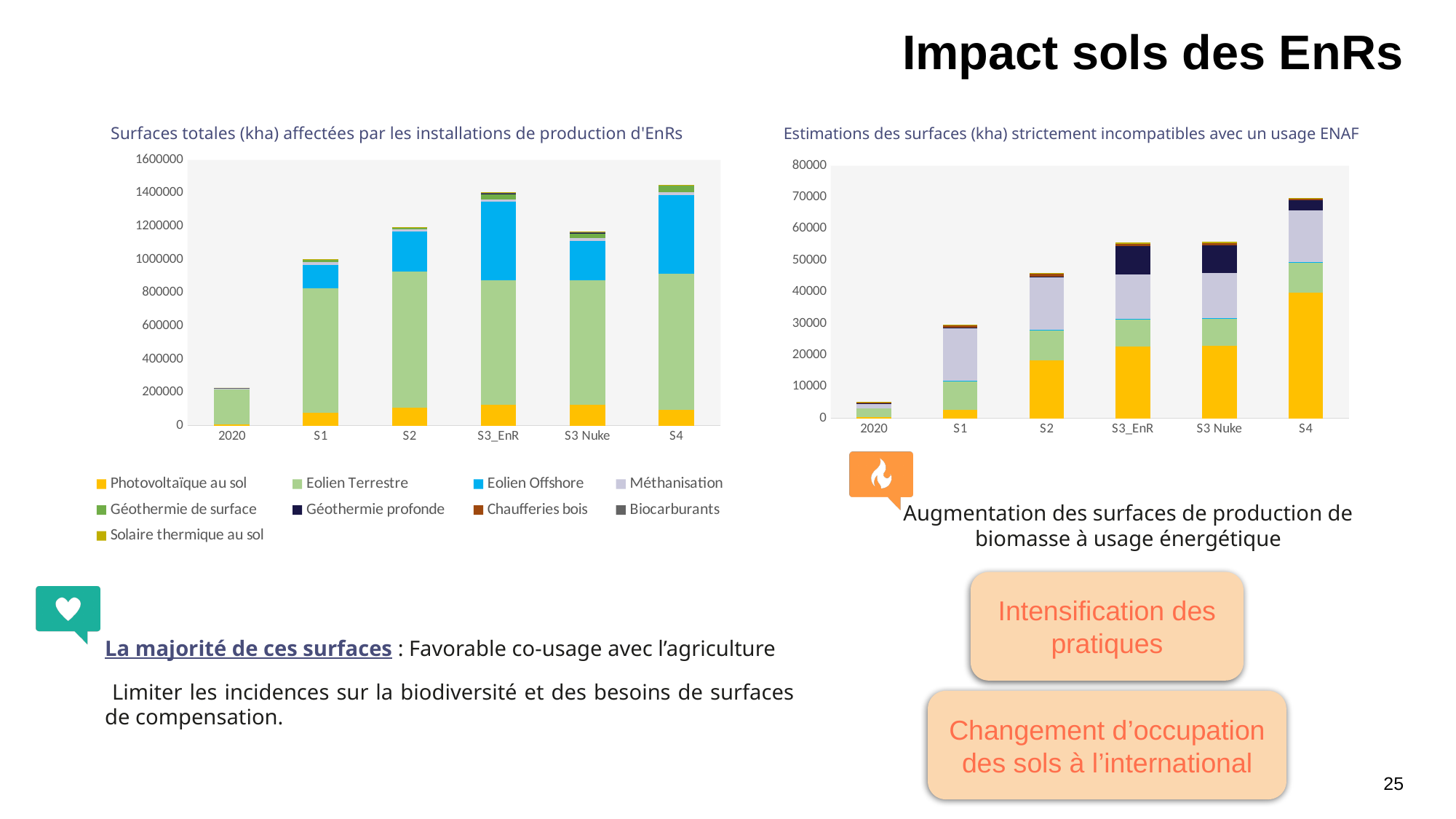
In the left chart, 'Surfaces totales (kha) affectées par les installations de production d'EnRs', which has the larger total, S3_EnR or S3 Nuke? S3_EnR In the left chart, 'Surfaces totales (kha) affectées par les installations de production d'EnRs', is the total for 2020 greater or less than 400000? less In the right chart, 'Estimations des surfaces (kha) strictement incompatibles avec un usage ENAF', do the totals generally rise or fall from 2020 to S4? Rise In the right chart, 'Estimations des surfaces (kha) strictement incompatibles avec un usage ENAF', which category has the highest total? S4 In the left chart, 'Surfaces totales (kha) affectées par les installations de production d'EnRs', is the total for S2 greater or less than 1000000? greater How many series does the legend of the left chart, 'Surfaces totales (kha) affectées par les installations de production d'EnRs', list? 9 In the right chart, 'Estimations des surfaces (kha) strictement incompatibles avec un usage ENAF', is the total for S4 greater or less than 60000? greater In the left chart, 'Surfaces totales (kha) affectées par les installations de production d'EnRs', which category has the lowest total? 2020 How many categories are shown on the x axis of the left chart, 'Surfaces totales (kha) affectées par les installations de production d'EnRs'? 6 What kind of chart is the left chart, 'Surfaces totales (kha) affectées par les installations de production d'EnRs'? Stacked bar chart In the left chart's legend, which colour represents 'Photovoltaïque au sol'? Yellow In the right chart, 'Estimations des surfaces (kha) strictement incompatibles avec un usage ENAF', which has the larger total, S2 or S3 Nuke? S3 Nuke